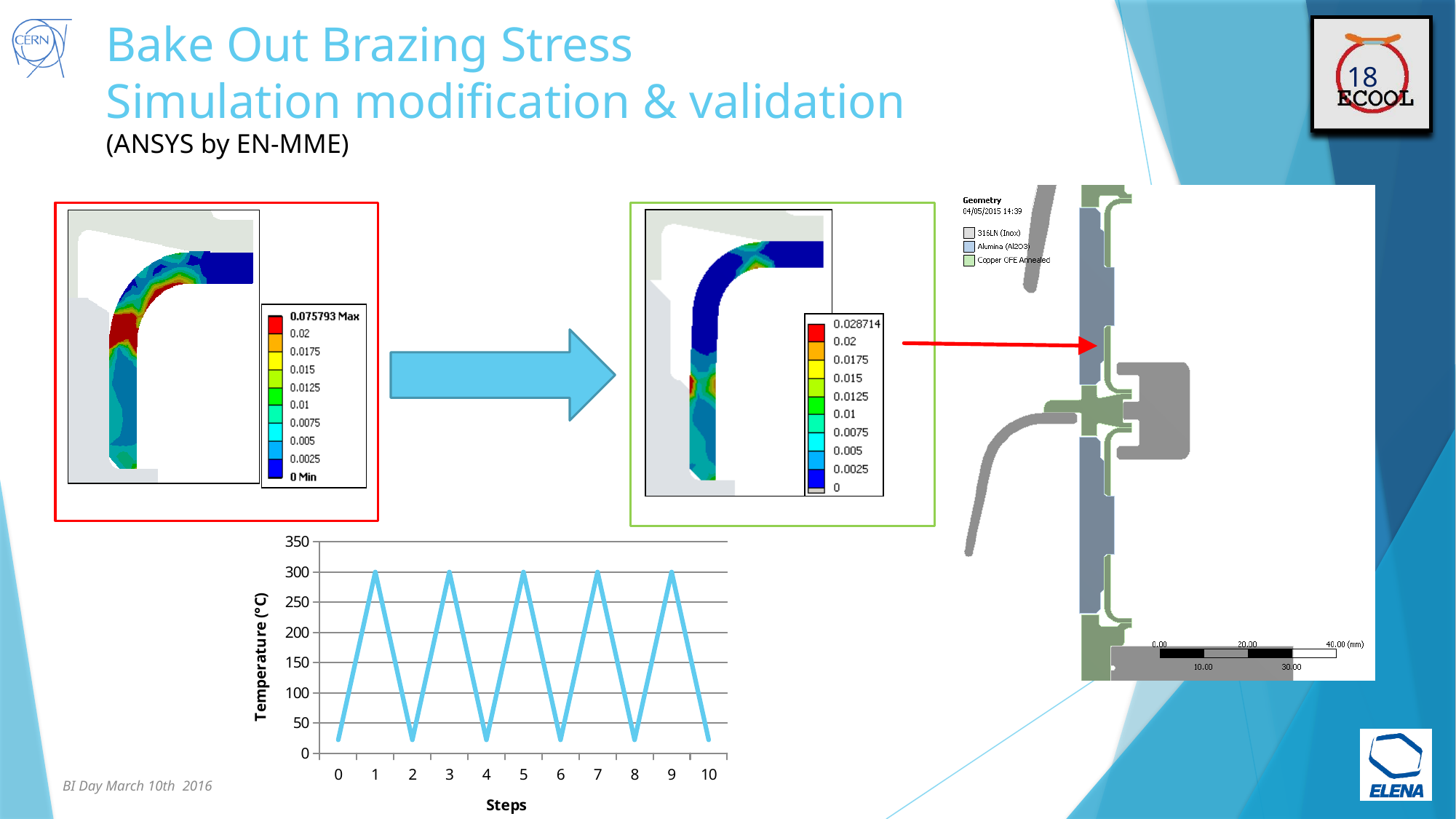
In the Temperature vs Steps chart, is the temperature at step 9 greater or less than 250? greater In the Temperature vs Steps chart, how many times does the temperature reach 300? 5 What is the highest tick value shown on the y axis of the Temperature vs Steps chart? 350 What kind of chart is the Temperature vs Steps chart at the bottom of the slide? line chart What is the maximum value shown in the legend of the left (red-framed) stress contour plot? 0.075793 In the Temperature vs Steps chart, what is the temperature at step 7? 300 What is the label of the y axis of the Temperature vs Steps chart? Temperature (°C) In the Temperature vs Steps chart, how many step values are labelled on the x axis? 11 In the Temperature vs Steps chart, is the temperature at step 2 greater or less than 50? less In the Temperature vs Steps chart, which has the higher temperature, step 3 or step 4? step 3 In the Temperature vs Steps chart, does the temperature rise or fall from step 0 to step 1? rise In the Temperature vs Steps chart, what is the temperature at step 1? 300